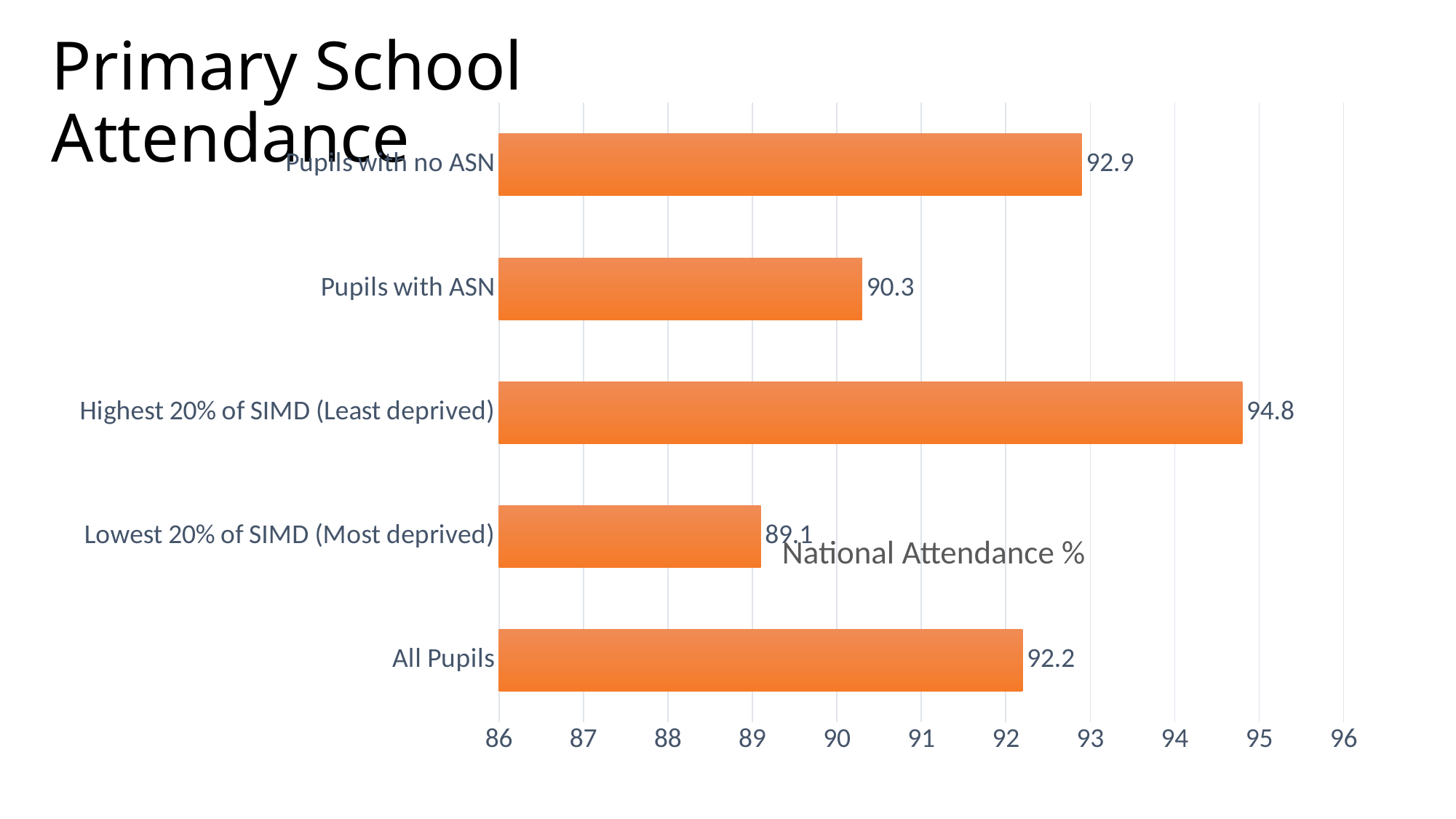
What is the National Attendance % for Pupils with ASN? 90.3 What is the difference in National Attendance % between Pupils with no ASN and Pupils with ASN? 2.6 What is the National Attendance % for Pupils with no ASN? 92.9 Which category has the lowest National Attendance %? Lowest 20% of SIMD (Most deprived) Which category has the highest National Attendance %? Highest 20% of SIMD (Least deprived) Which has a higher National Attendance %, Pupils with ASN or All Pupils? All Pupils What is the difference in National Attendance % between the Highest 20% of SIMD (Least deprived) and the Lowest 20% of SIMD (Most deprived)? 5.7 How many categories are shown in the chart? 5 What is the National Attendance % for All Pupils? 92.2 What kind of chart is shown on the slide? Bar chart What is the National Attendance % for the Lowest 20% of SIMD (Most deprived)? 89.1 Is the value for Pupils with ASN greater or less than 91? less